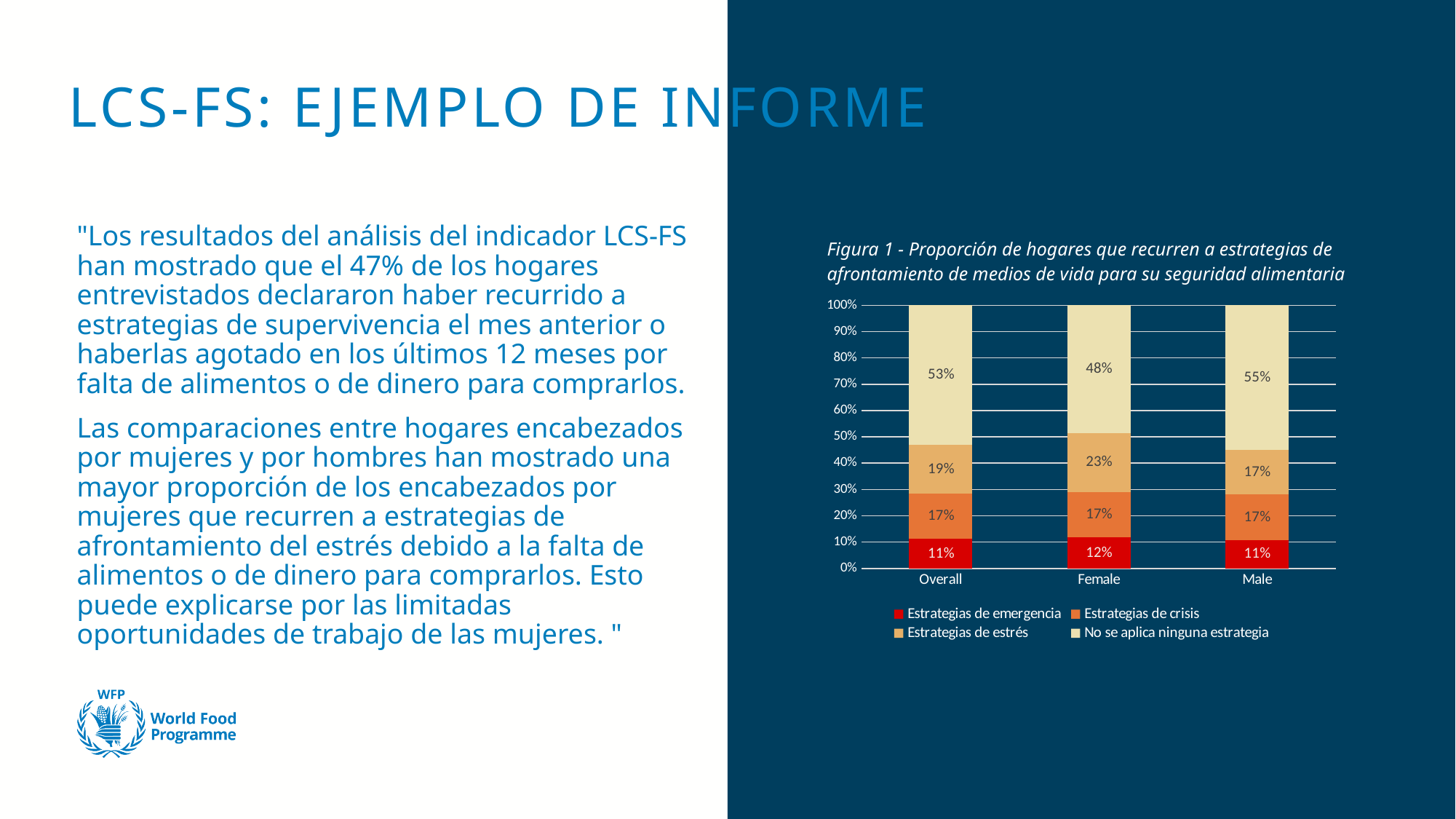
Which legend entry is shown in red? Estrategias de emergencia Which category has the highest value for 'No se aplica ninguna estrategia'? Male What kind of chart is shown on the slide? Stacked bar chart What is the value for 'No se aplica ninguna estrategia' in the Male category? 55% What is the combined share of 'Estrategias de emergencia' and 'Estrategias de crisis' for the Female category? 29% How many categories are shown on the x axis? 3 Is the 'Estrategias de emergencia' value larger for Female or for Male? Female What is the value for 'Estrategias de emergencia' in the Overall category? 11% What percentage of Female-headed households fall under 'Estrategias de estrés'? 23% What is the difference between the 'Estrategias de estrés' values for Female and Male? 6% How many series does the legend list? 4 Which category has the lowest value for 'Estrategias de estrés'? Male